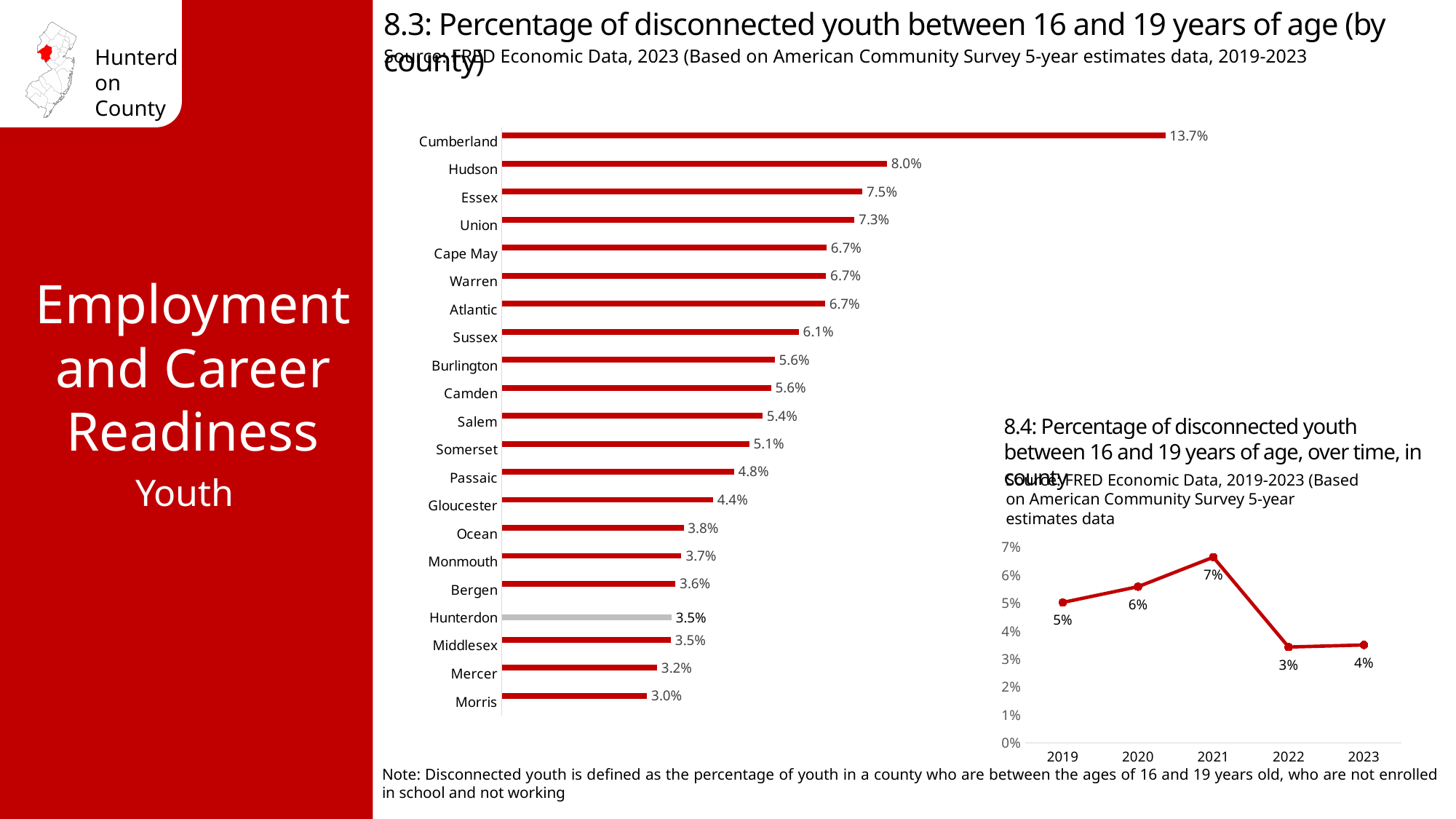
In chart 8.4 (percentage of disconnected youth over time), what is the value for 2021? 7% In chart 8.3 (percentage of disconnected youth by county), how many counties are shown? 21 In chart 8.4 (percentage of disconnected youth over time), how many data points are plotted? 5 In chart 8.3 (percentage of disconnected youth by county), which bar is coloured grey instead of red? Hunterdon In chart 8.3 (percentage of disconnected youth by county), what is the value for Hunterdon? 3.5% In chart 8.3 (percentage of disconnected youth by county), which county has the highest value? Cumberland In chart 8.4 (percentage of disconnected youth over time), which year has the lowest value? 2022 In chart 8.3 (percentage of disconnected youth by county), which county has the lowest value? Morris What kind of chart is chart 8.3 (percentage of disconnected youth by county)? Bar chart In chart 8.3 (percentage of disconnected youth by county), what is the value for Hudson? 8.0% In chart 8.3 (percentage of disconnected youth by county), what is the difference between Cumberland and Hudson? 5.7% In chart 8.3 (percentage of disconnected youth by county), which is larger, the value for Essex or the value for Union? Essex